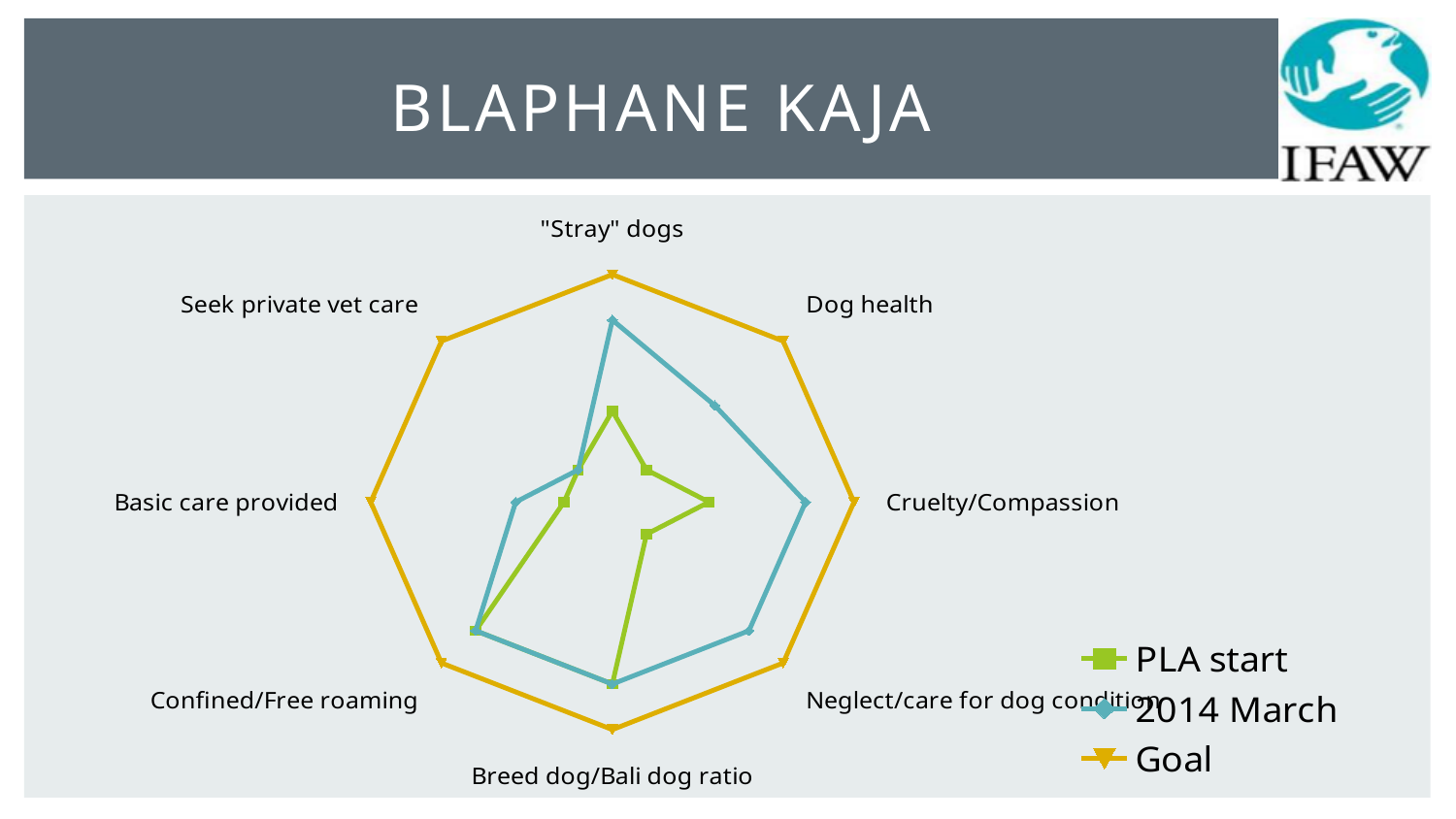
For the PLA start series, which category has the highest value? Breed dog/Bali dog ratio and Confined/Free roaming (tied) For Neglect/care for dog condition, which series has the larger value: Goal or PLA start? Goal Which series forms the outermost line on the radar chart? Goal How many categories (axes) does the radar chart have? 8 What kind of chart is shown on the slide? Radar chart For "Stray" dogs, which series has the larger value: PLA start or 2014 March? 2014 March For Dog health, which series has the larger value: Goal or 2014 March? Goal How many series does the legend list? 3 Which series are listed in the legend? PLA start, 2014 March, Goal